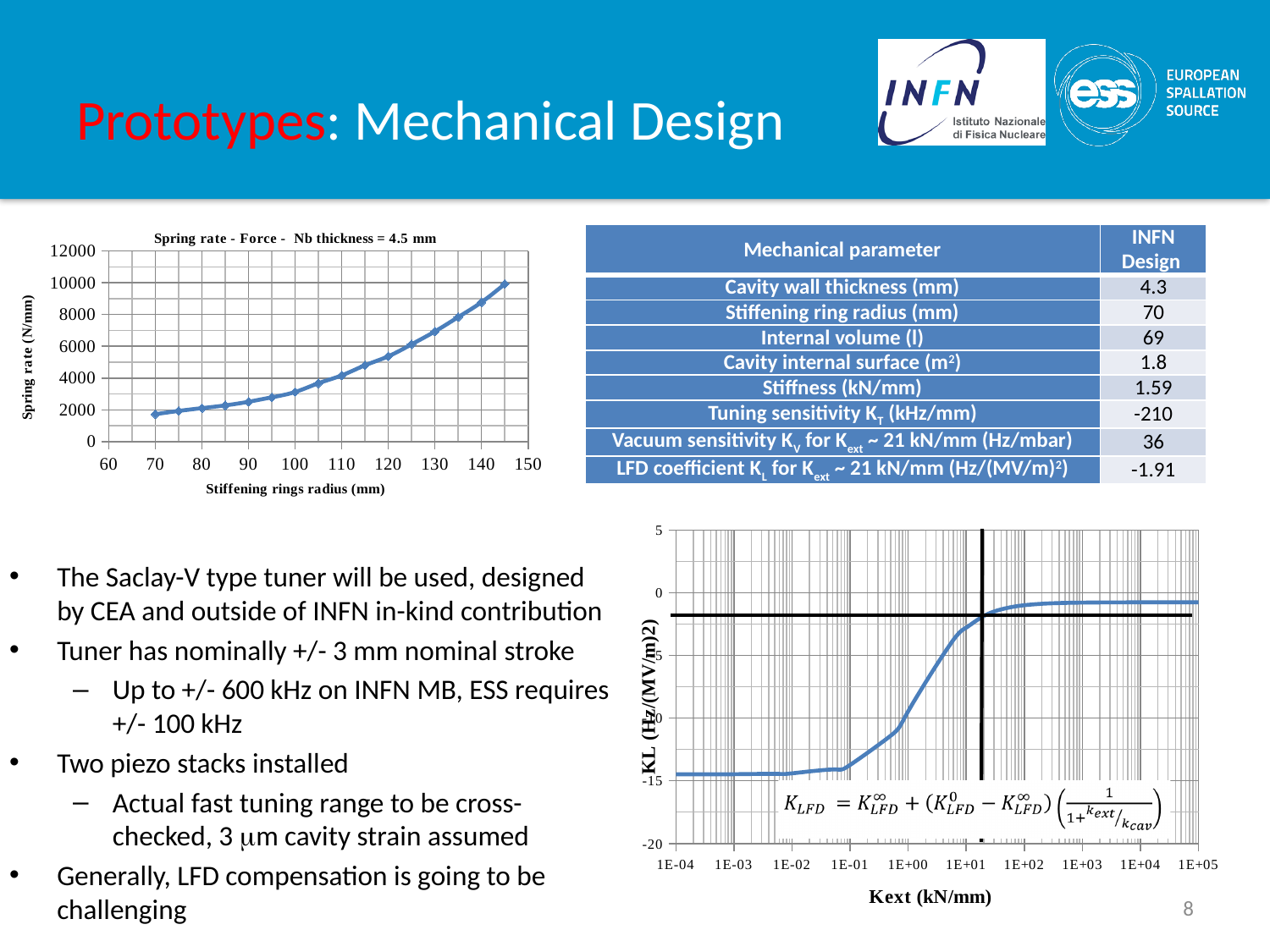
In the top-left chart 'Spring rate - Force - Nb thickness = 4.5 mm', is the spring rate at a stiffening rings radius of 100 mm greater or less than 4000? less What is the x-axis label of the top-left chart 'Spring rate - Force - Nb thickness = 4.5 mm'? Stiffening rings radius (mm) What type of chart is the top-left chart titled 'Spring rate - Force - Nb thickness = 4.5 mm'? Line chart In the bottom-right chart of KL versus Kext, is the value of KL at Kext = 1E+04 kN/mm greater or less than -5? greater In the top-left chart 'Spring rate - Force - Nb thickness = 4.5 mm', is the spring rate at a stiffening rings radius of 145 mm greater or less than 8000? greater In the top-left chart 'Spring rate - Force - Nb thickness = 4.5 mm', does the spring rate rise or fall as the stiffening rings radius increases? Rises In the top-left chart 'Spring rate - Force - Nb thickness = 4.5 mm', which stiffening rings radius has the highest spring rate? 145 mm In the bottom-right chart of KL versus Kext, does KL rise or fall as Kext increases? Rises In the top-left chart 'Spring rate - Force - Nb thickness = 4.5 mm', which stiffening rings radius has the lowest spring rate? 70 mm What type of chart is the bottom-right chart plotting KL against Kext? Line chart